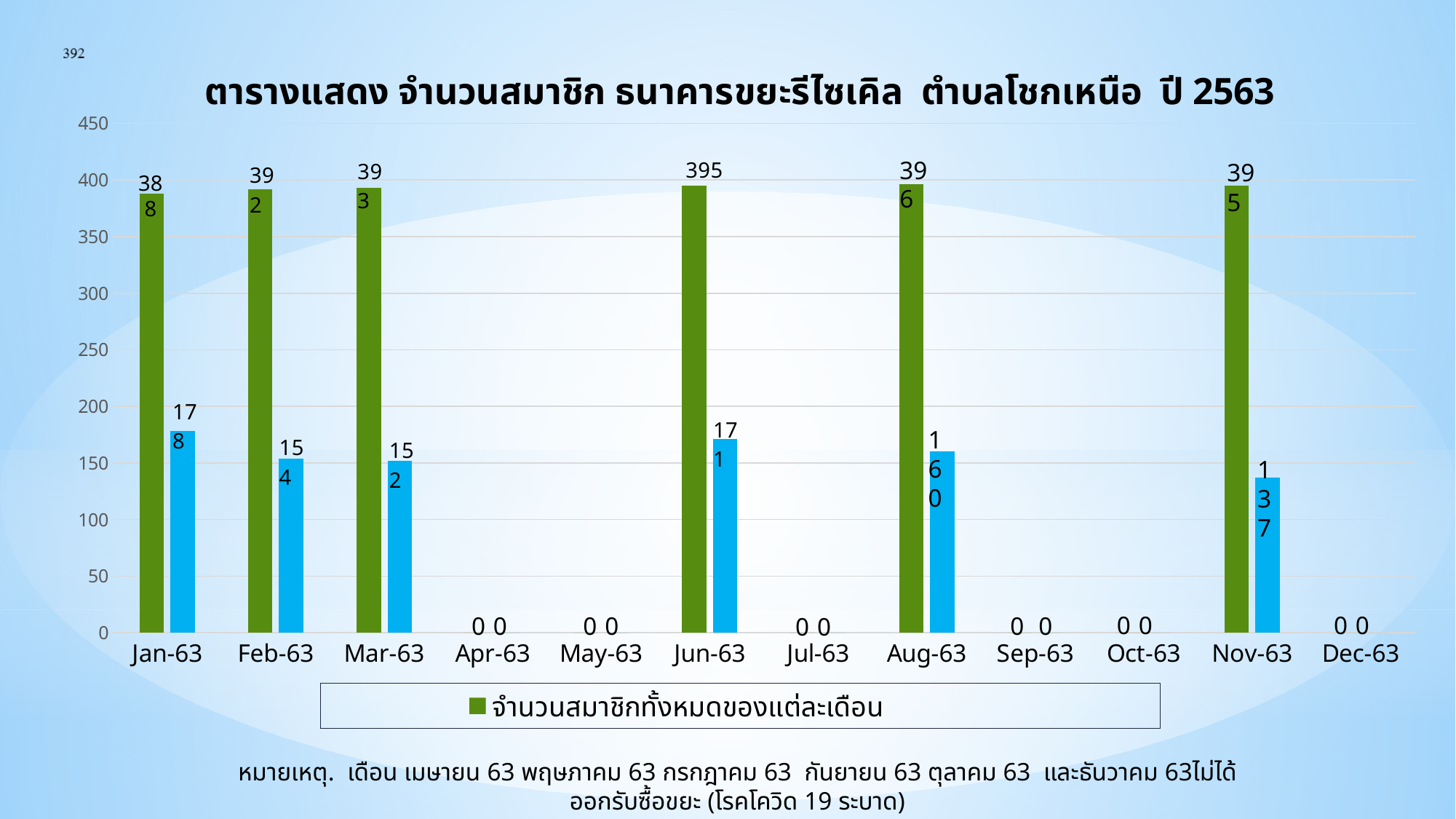
What is the value of the green bar (จำนวนสมาชิกทั้งหมดของแต่ละเดือน) for Jan-63? 388 Which is larger, the blue bar for Jan-63 or the blue bar for Nov-63? Jan-63 How many months are shown on the x axis of the chart? 12 What is the difference between the green bar and the blue bar for Jan-63? 210 What is the value shown for Apr-63? 0 Is the value of the green bar for Mar-63 greater or less than 350? greater What is the value of the blue bar for Nov-63? 137 What is the value of the green bar for Jun-63? 395 Which month has the highest value for the green series? Aug-63 What kind of chart is shown on the slide? bar chart How many series does the chart's legend list? 1 What is the value of the blue bar for Jan-63? 178